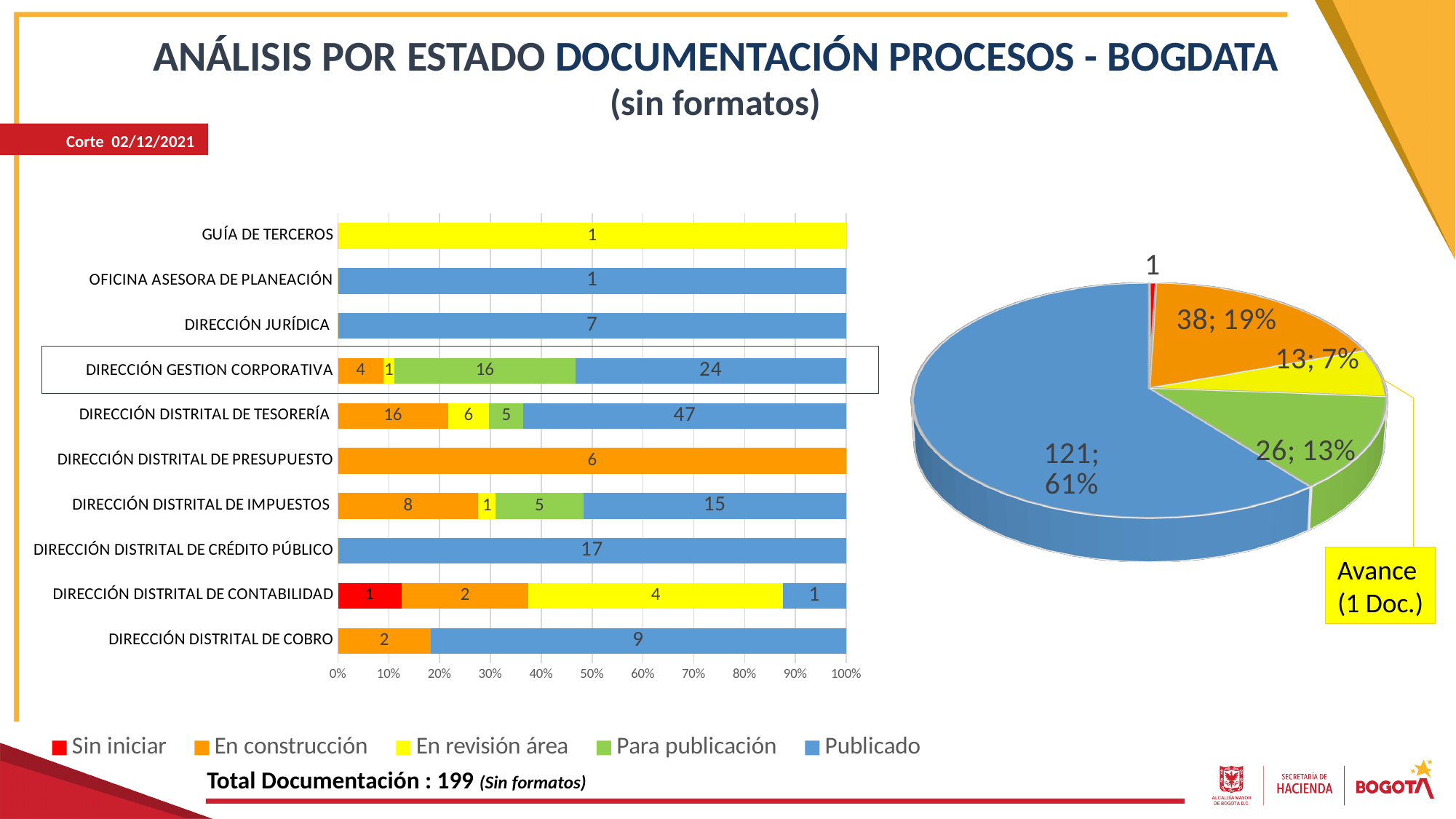
In the bar chart, what is the difference between the Publicado values for DIRECCIÓN DISTRITAL DE TESORERÍA and DIRECCIÓN GESTION CORPORATIVA? 23 In the bar chart, what is the Para publicación value for DIRECCIÓN GESTION CORPORATIVA? 16 In the pie chart, what is the value of the En construcción (orange) slice? 38 In the bar chart, how many categories (directions/offices) are listed on the vertical axis? 10 In the bar chart, which is larger: the En construcción value for DIRECCIÓN DISTRITAL DE TESORERÍA or for DIRECCIÓN DISTRITAL DE IMPUESTOS? DIRECCIÓN DISTRITAL DE TESORERÍA In the bar chart, what is the total of the stacked bar for DIRECCIÓN DISTRITAL DE CONTABILIDAD? 8 What kind of chart is the chart on the left side of the slide? Stacked bar chart In the bar chart, what is the En construcción value for DIRECCIÓN DISTRITAL DE IMPUESTOS? 8 In the bar chart, what is the Publicado value for DIRECCIÓN DISTRITAL DE TESORERÍA? 47 In the pie chart, what share does the Publicado (blue) slice represent? 61% In the bar chart, what is the total of the stacked bar for DIRECCIÓN DISTRITAL DE COBRO? 11 How many series does the legend list? 5